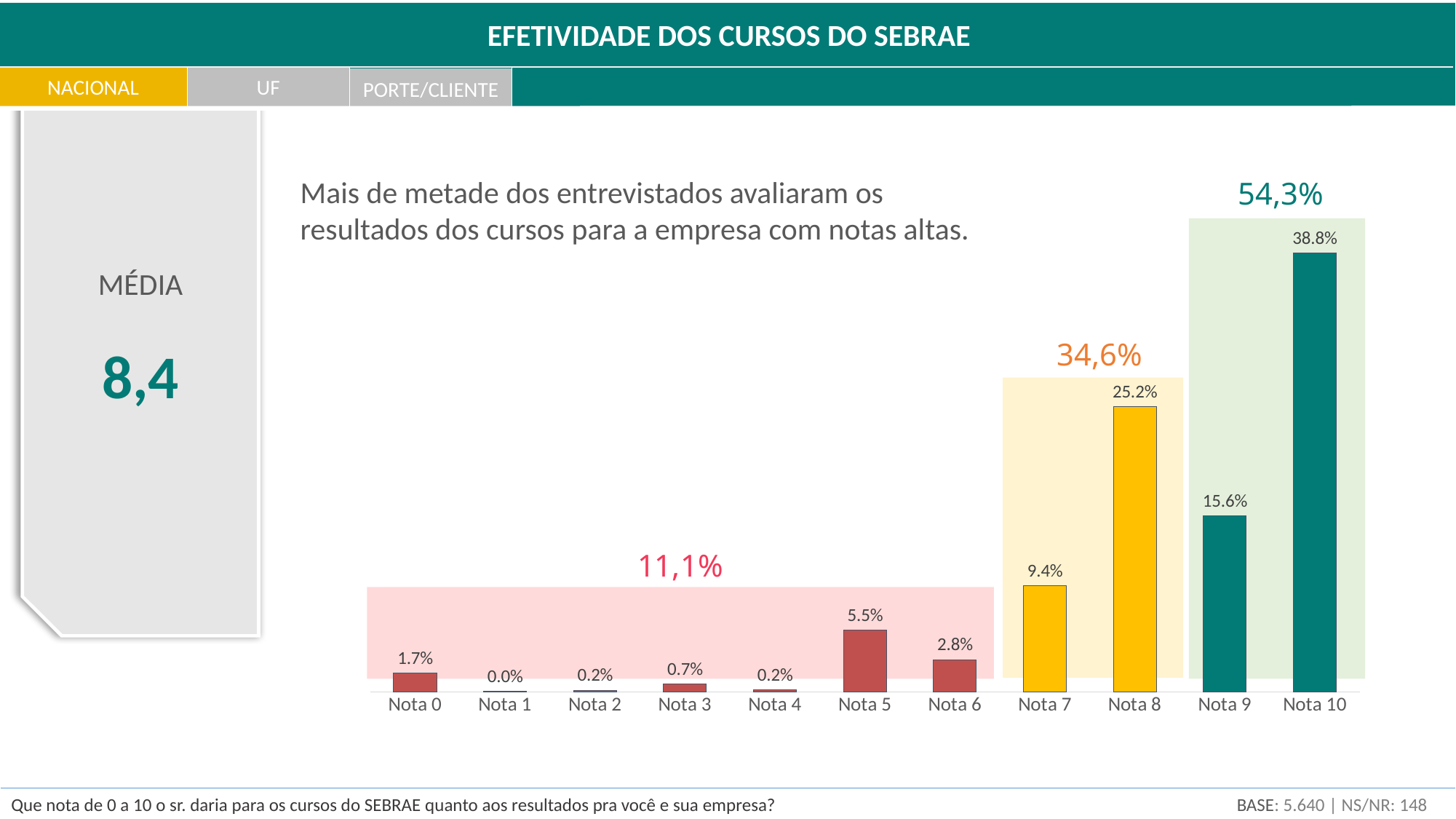
How many categories are shown on the x axis? 11 Which category has the highest value? Nota 10 Which is larger, the value for Nota 8 or the value for Nota 9? Nota 8 What is the value for Nota 8? 25.2% What kind of chart is shown on the slide? bar chart What is the value for Nota 10? 38.8% What is the average (MÉDIA) score shown on the slide? 8,4 What is the value for Nota 5? 5.5% What is the difference between the values for Nota 10 and Nota 9? 23.2% What is the combined share shown for the group Nota 9 and Nota 10? 54,3% Which category has the lowest value? Nota 1 What is the value for Nota 1? 0.0%